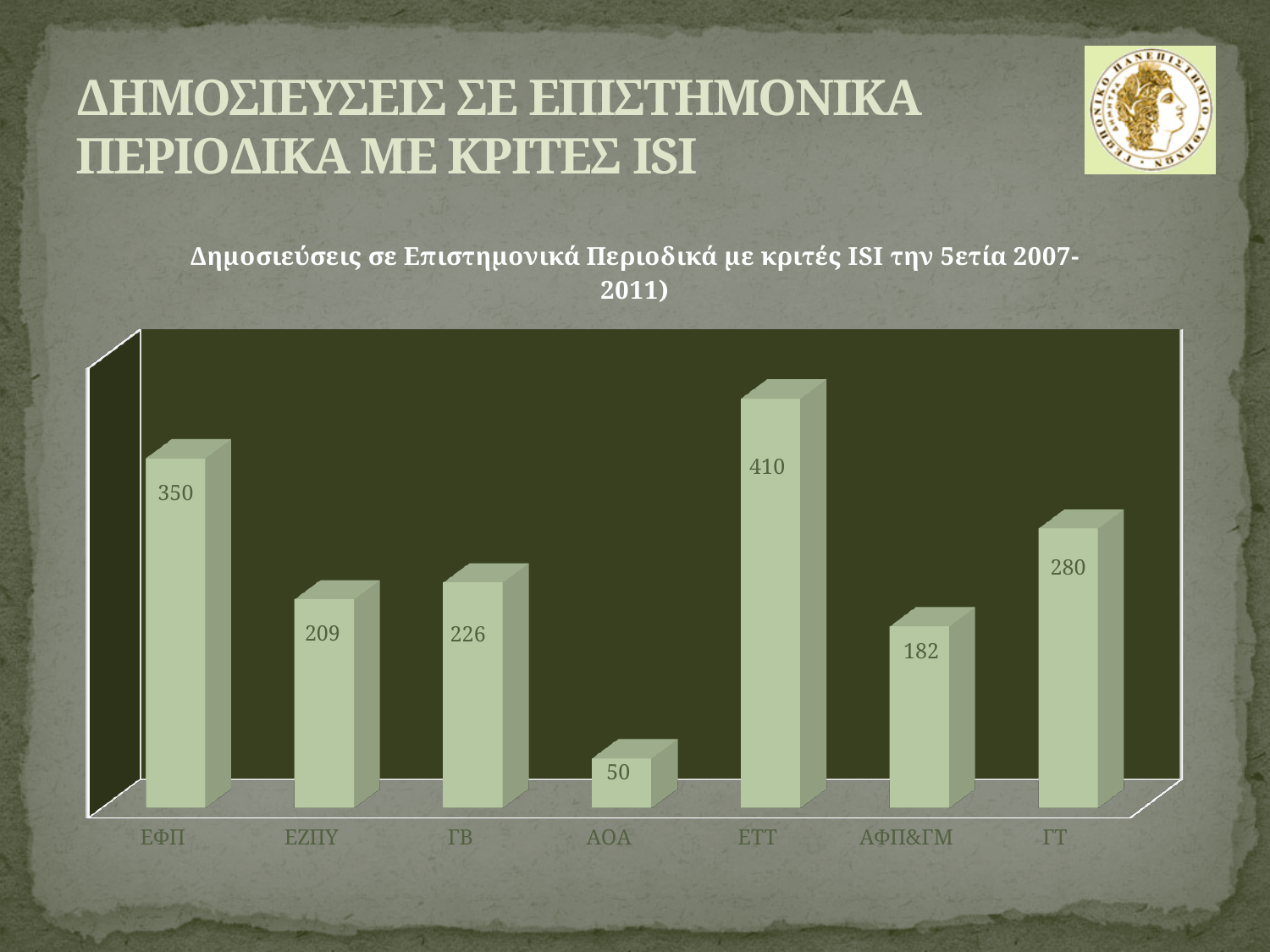
What is the value for ΕΤΤ? 410 What is the value for ΑΟΑ? 50 Which is larger, the value for ΓΤ or the value for ΓΒ? ΓΤ What is the total of the values for ΕΦΠ and ΕΖΠΥ? 559 Which category has the lowest value? ΑΟΑ How many categories are shown on the x axis? 7 What kind of chart is shown on the slide? bar chart What is the difference between the values for ΓΒ and ΕΖΠΥ? 17 What is the value for ΓΤ? 280 What is the difference between the values for ΕΤΤ and ΕΦΠ? 60 Which category has the highest value? ΕΤΤ What is the value for ΑΦΠ&ΓΜ? 182